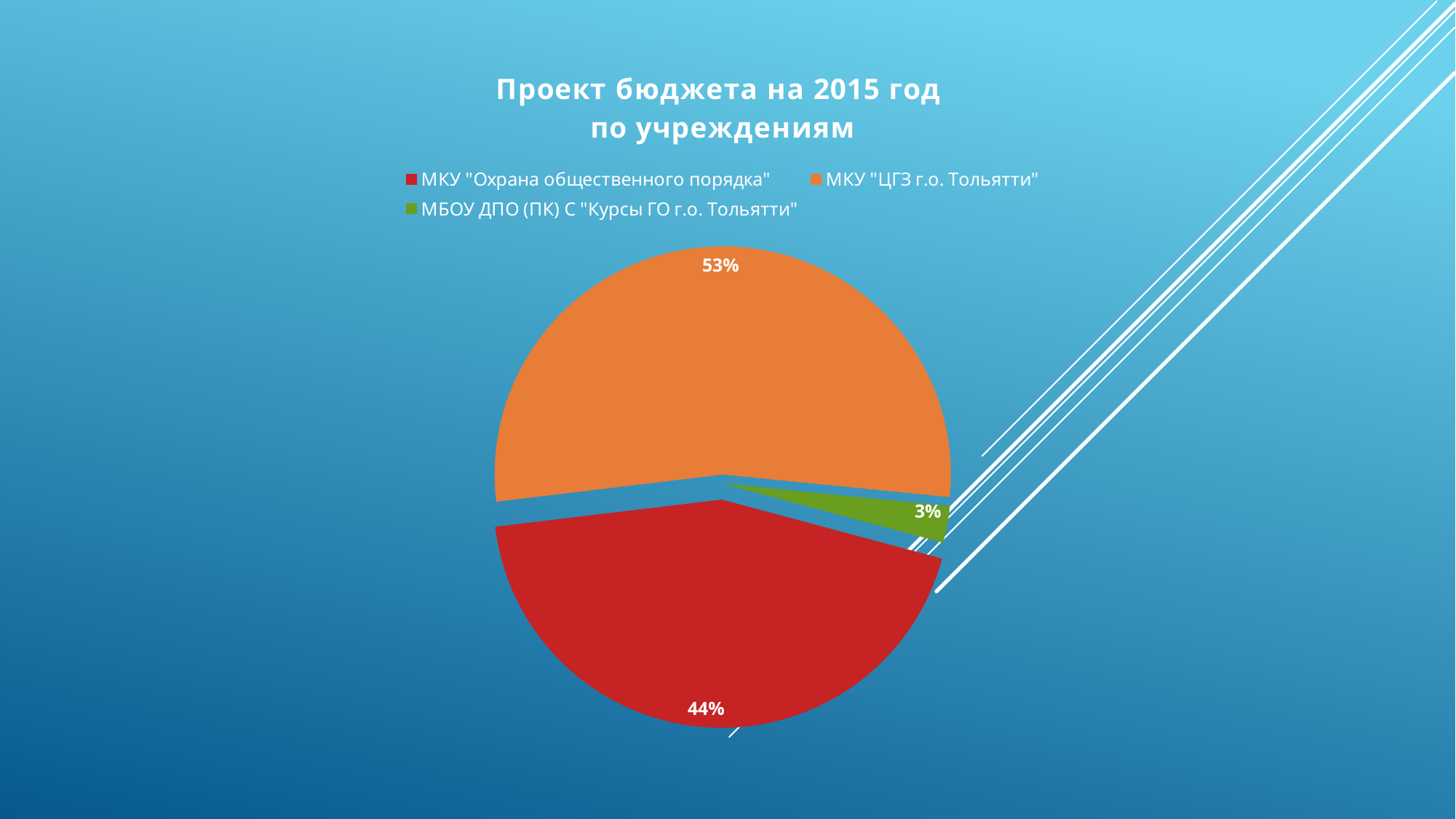
What is the title of the chart? Проект бюджета на 2015 год по учреждениям What colour is the slice for МКУ "Охрана общественного порядка"? red What share of the pie does МКУ "ЦГЗ г.о. Тольятти" have? 53% Which institution has the smallest share of the budget? МБОУ ДПО (ПК) С "Курсы ГО г.о. Тольятти" What is the difference in percentage points between the shares of МКУ "ЦГЗ г.о. Тольятти" and МКУ "Охрана общественного порядка"? 9% What share of the pie does МКУ "Охрана общественного порядка" have? 44% Which has a larger share: МКУ "Охрана общественного порядка" or МБОУ ДПО (ПК) С "Курсы ГО г.о. Тольятти"? МКУ "Охрана общественного порядка" Which institution has the largest share of the budget? МКУ "ЦГЗ г.о. Тольятти" What share of the pie does МБОУ ДПО (ПК) С "Курсы ГО г.о. Тольятти" have? 3% How many entries does the legend list? 3 How many slices does the pie chart have? 3 What kind of chart is shown on the slide? pie chart